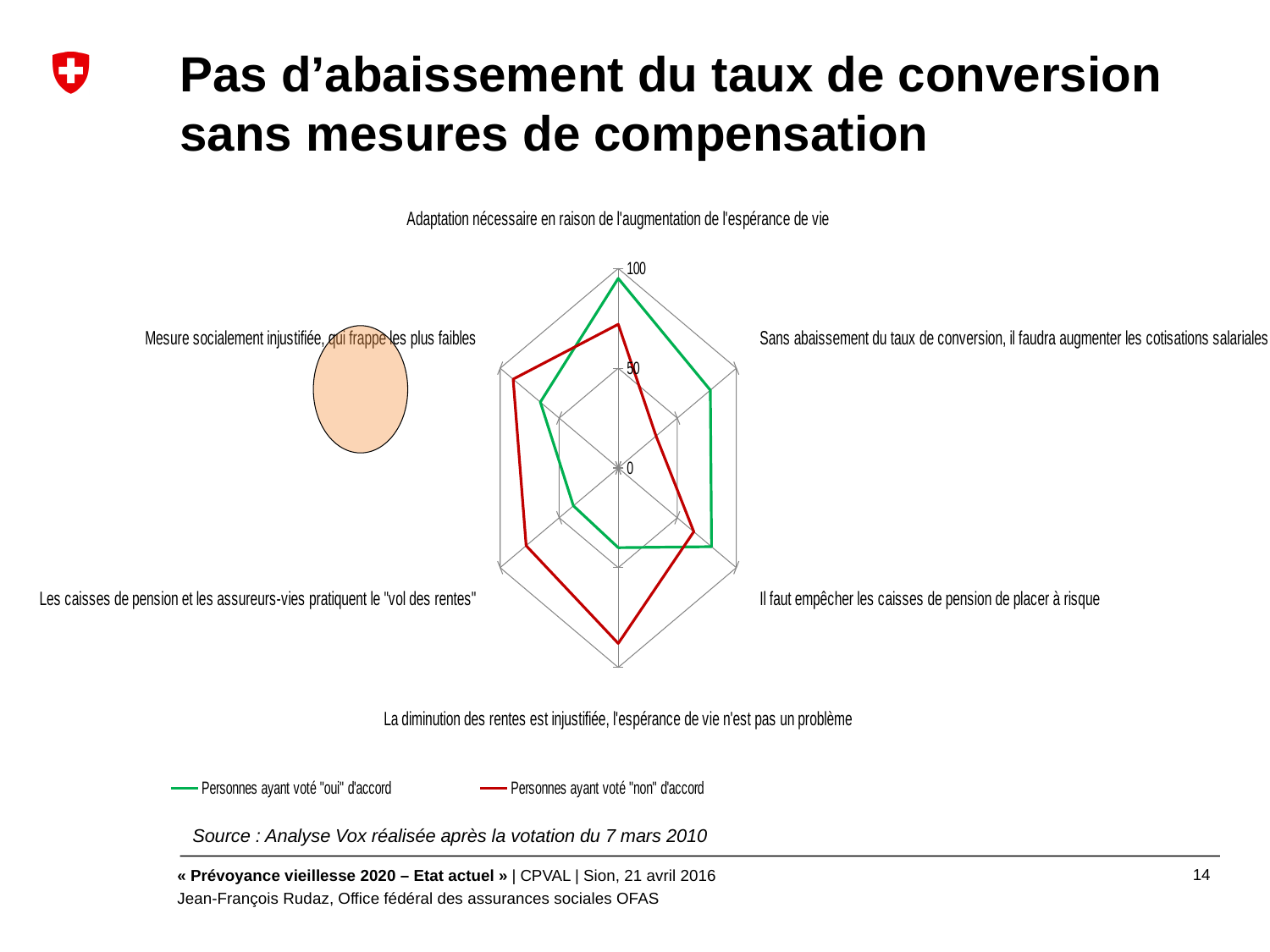
For the statement "La diminution des rentes est injustifiée, l'espérance de vie n'est pas un problème", which series has the larger value: Personnes ayant voté "oui" d'accord or Personnes ayant voté "non" d'accord? Personnes ayant voté "non" d'accord How many categories (statements) are plotted on the radar chart? 6 For the statement "Les caisses de pension et les assureurs-vies pratiquent le "vol des rentes"", is the value for Personnes ayant voté "oui" d'accord greater or less than 50? less For the statement "La diminution des rentes est injustifiée, l'espérance de vie n'est pas un problème", is the value for Personnes ayant voté "non" d'accord greater or less than 50? greater For the statement "Adaptation nécessaire en raison de l'augmentation de l'espérance de vie", is the value for Personnes ayant voté "oui" d'accord greater or less than 50? greater Which series is drawn in green on the radar chart? Personnes ayant voté "oui" d'accord For which statement does the series Personnes ayant voté "oui" d'accord reach its highest value? Adaptation nécessaire en raison de l'augmentation de l'espérance de vie How many series does the legend of the radar chart list? 2 What kind of chart is shown on the slide? Radar chart What is the highest value shown on the radar chart's axis scale? 100 For the statement "Adaptation nécessaire en raison de l'augmentation de l'espérance de vie", which series has the larger value: Personnes ayant voté "oui" d'accord or Personnes ayant voté "non" d'accord? Personnes ayant voté "oui" d'accord